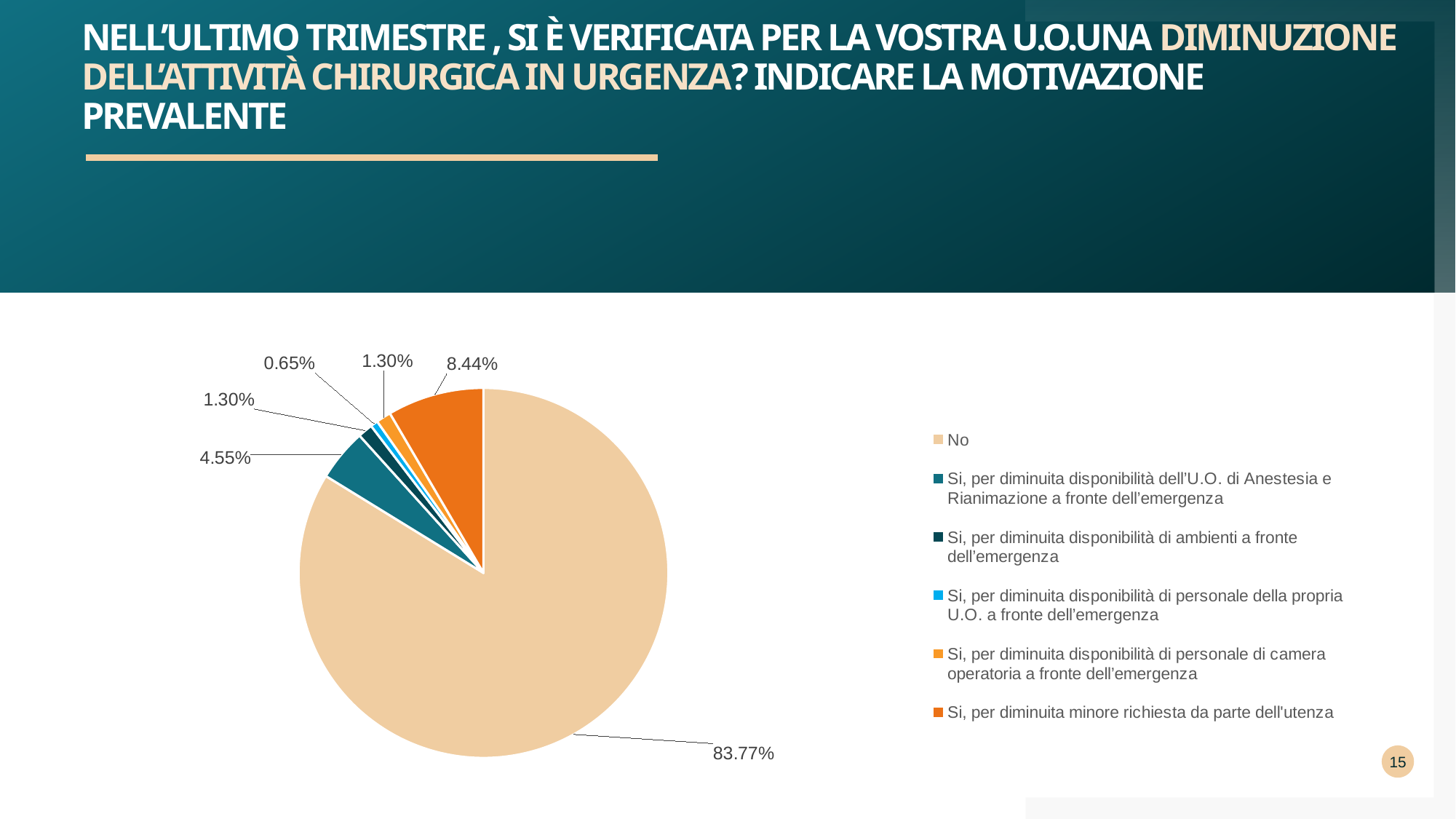
What is the difference between the "No" slice and the "Si, per diminuita minore richiesta da parte dell'utenza" slice? 75.33% Which category has the largest slice of the pie? No What is the value for "Si, per diminuita disponibilità dell'U.O. di Anestesia e Rianimazione a fronte dell'emergenza"? 4.55% What kind of chart is shown on the slide? Pie chart What colour is the "No" slice in the pie chart? Beige How many categories are shown in the pie chart? 6 Which category has the smallest slice of the pie? Si, per diminuita disponibilità di personale della propria U.O. a fronte dell'emergenza What is the value for "Si, per diminuita disponibilità di personale della propria U.O. a fronte dell'emergenza"? 0.65% Which is larger: the slice for "Si, per diminuita disponibilità dell'U.O. di Anestesia e Rianimazione" or the slice for "Si, per diminuita minore richiesta da parte dell'utenza"? Si, per diminuita minore richiesta da parte dell'utenza What share of the pie does the "No" slice represent? 83.77% What is the value for "Si, per diminuita minore richiesta da parte dell'utenza"? 8.44% What is the difference between the "Si, per diminuita minore richiesta da parte dell'utenza" slice and the "Si, per diminuita disponibilità dell'U.O. di Anestesia e Rianimazione" slice? 3.89%